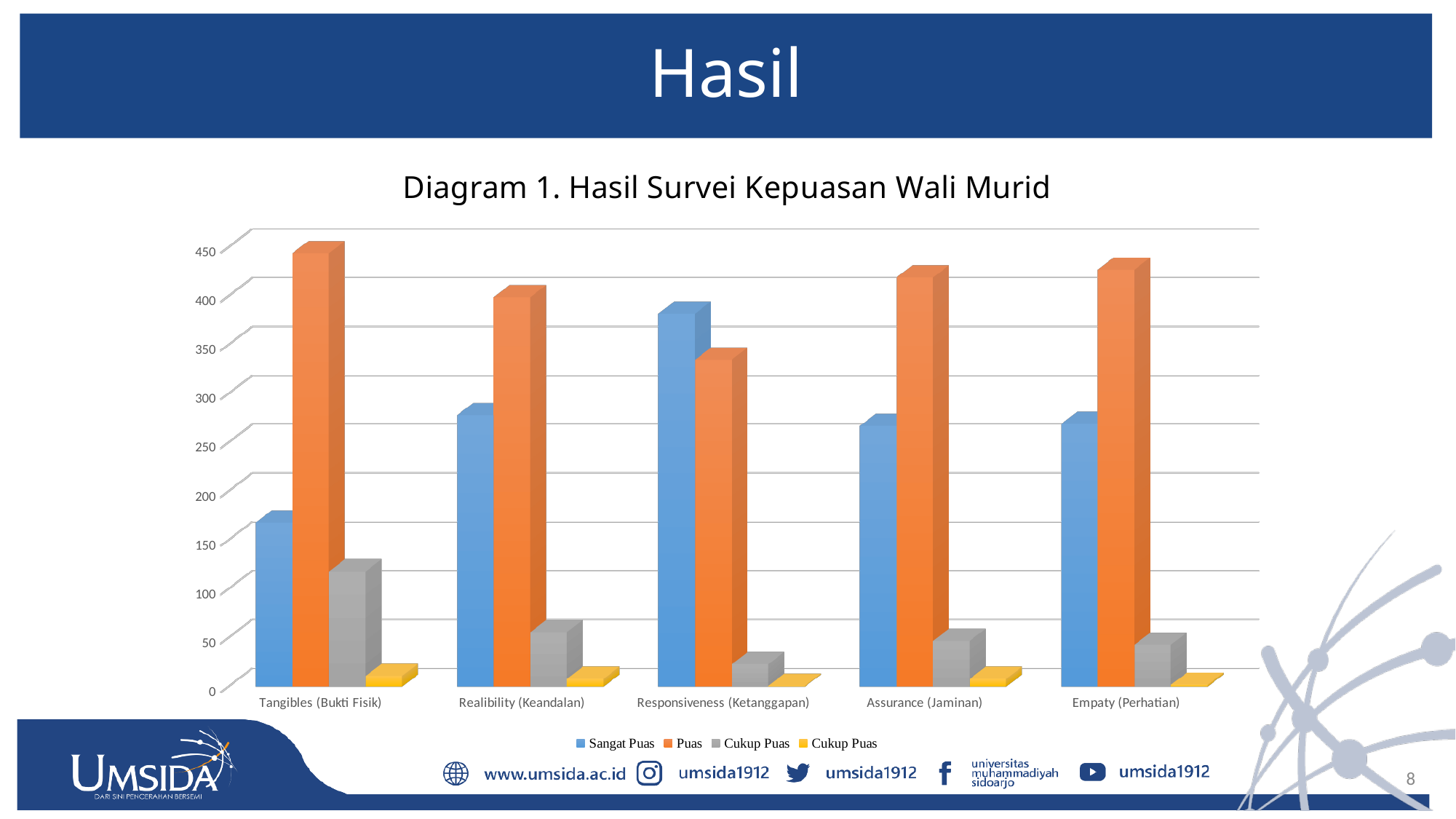
For Tangibles (Bukti Fisik), which is larger: Sangat Puas or Puas? Puas Which category has the highest Sangat Puas value? Responsiveness (Ketanggapan) Which category has the lowest Sangat Puas value? Tangibles (Bukti Fisik) What kind of chart is shown on the slide? bar chart What is the title of the chart? Diagram 1. Hasil Survei Kepuasan Wali Murid Which category has the highest Cukup Puas (grey) value? Tangibles (Bukti Fisik) Is the Puas value for Tangibles (Bukti Fisik) greater or less than 400? greater Is the Sangat Puas value for Tangibles (Bukti Fisik) greater or less than 200? less How many series does the chart legend list? 4 How many categories are shown on the x axis of the chart? 5 Which category has the lowest Puas value? Responsiveness (Ketanggapan) For Responsiveness (Ketanggapan), which is larger: Sangat Puas or Puas? Sangat Puas